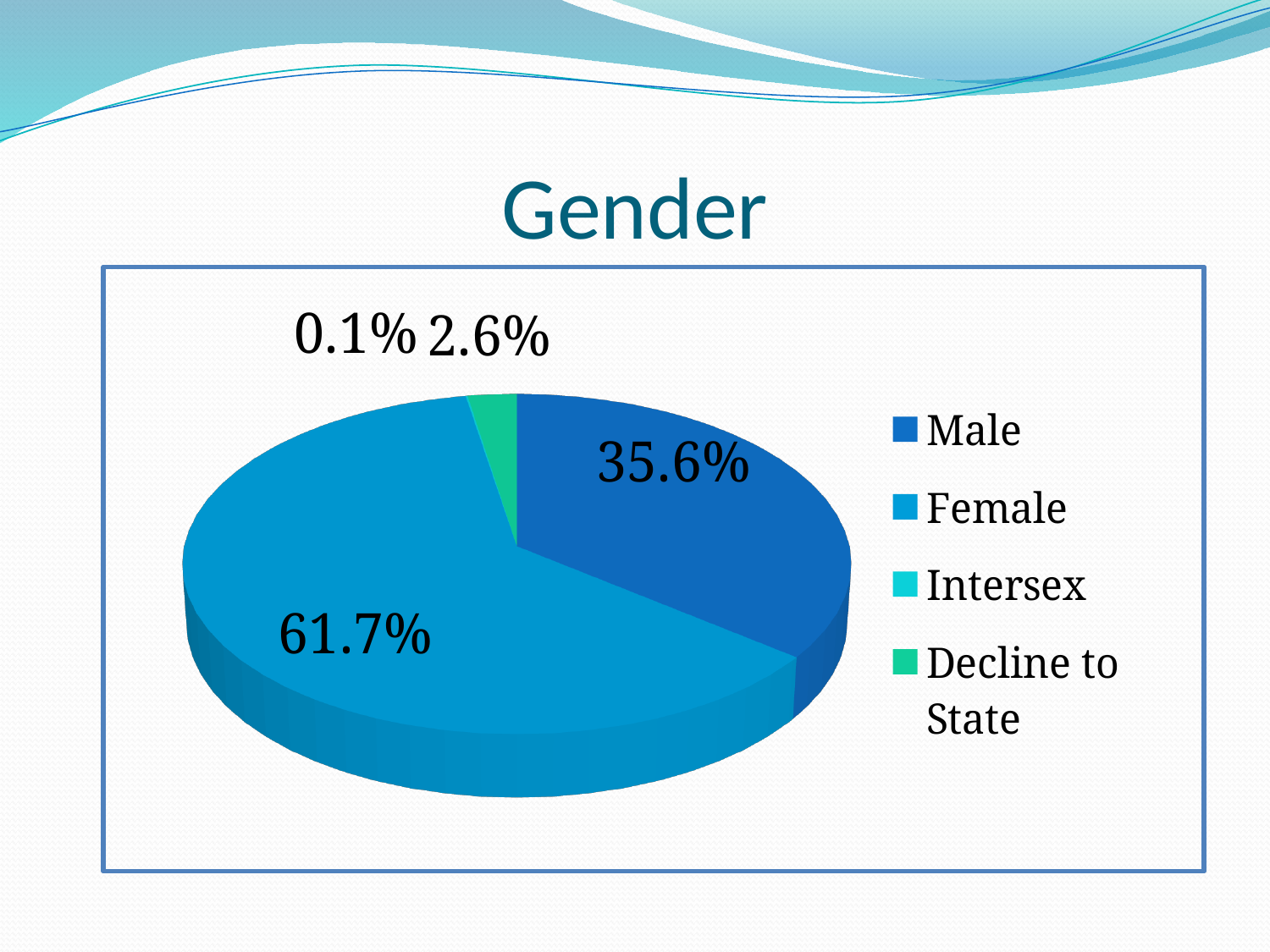
Which is larger, the Male share or the Decline to State share? Male Which category has the largest share of the pie? Female What is the difference between the Female and Male shares? 26.1% Which category has the smallest share of the pie? Intersex What is the combined share of Intersex and Decline to State? 2.7% What percentage of the pie is Male? 35.6% How many categories does the legend list? 4 What is the title of the chart? Gender What percentage of the pie is Female? 61.7% What percentage of the pie is Decline to State? 2.6% What percentage of the pie is Intersex? 0.1% What kind of chart is shown on the slide? pie chart